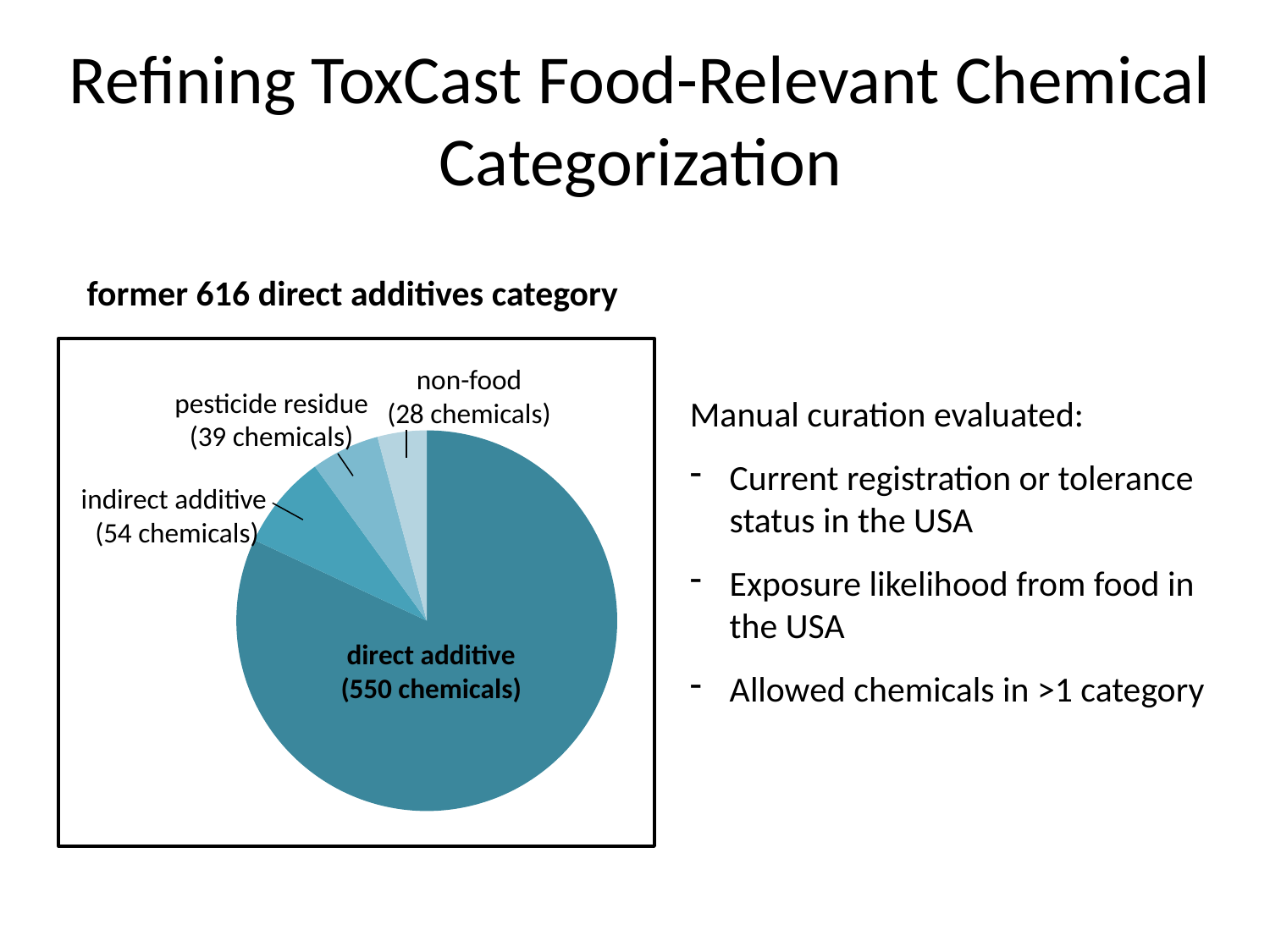
Which category has the smallest slice in the pie chart? non-food How many chemicals are in the indirect additive slice of the pie chart? 54 chemicals How many more chemicals are in the indirect additive slice than in the pesticide residue slice? 15 Which category has the largest slice in the pie chart? direct additive How many chemicals are in the direct additive slice of the pie chart? 550 chemicals How many chemicals are in the non-food slice of the pie chart? 28 chemicals How many more chemicals are in the direct additive slice than in the non-food slice? 522 What is the heading printed above the pie chart? former 616 direct additives category What kind of chart is shown on the slide? pie chart How many chemicals are in the pesticide residue slice of the pie chart? 39 chemicals Which slice has more chemicals, pesticide residue or non-food? pesticide residue How many slices does the pie chart have? 4